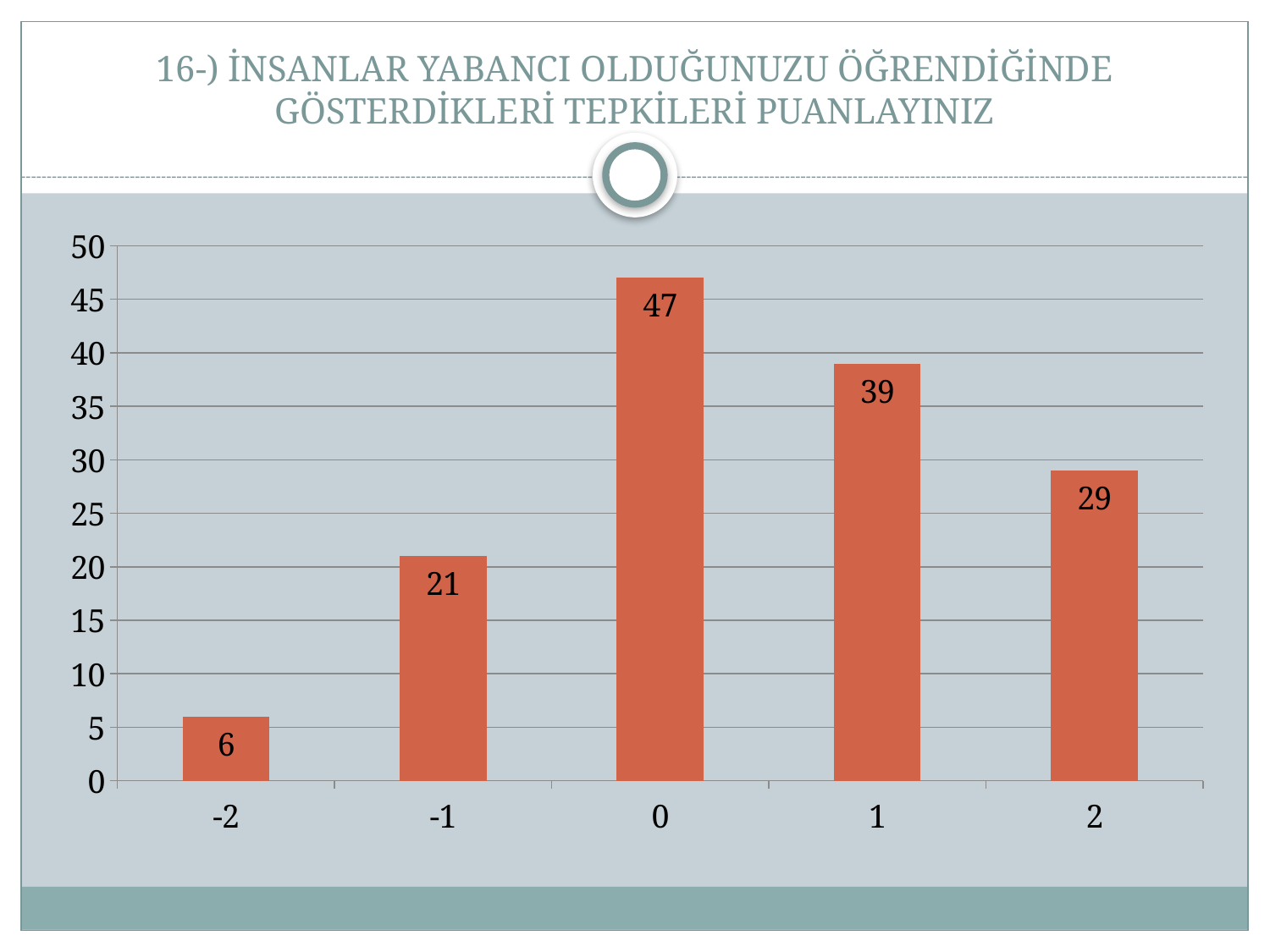
What is the total of all five bar values? 142 How many categories are shown on the x axis? 5 What is the value for category 2? 29 What is the value for category -2? 6 What kind of chart is shown on the slide? bar chart What is the difference between the values for category -1 and category -2? 15 Which category has the lowest value? -2 Which category has the highest value? 0 Which is larger, the value for category 1 or the value for category 2? 1 Is the value for category -1 greater or less than 25? less What is the value for category 0? 47 What is the difference between the values for category 0 and category 1? 8